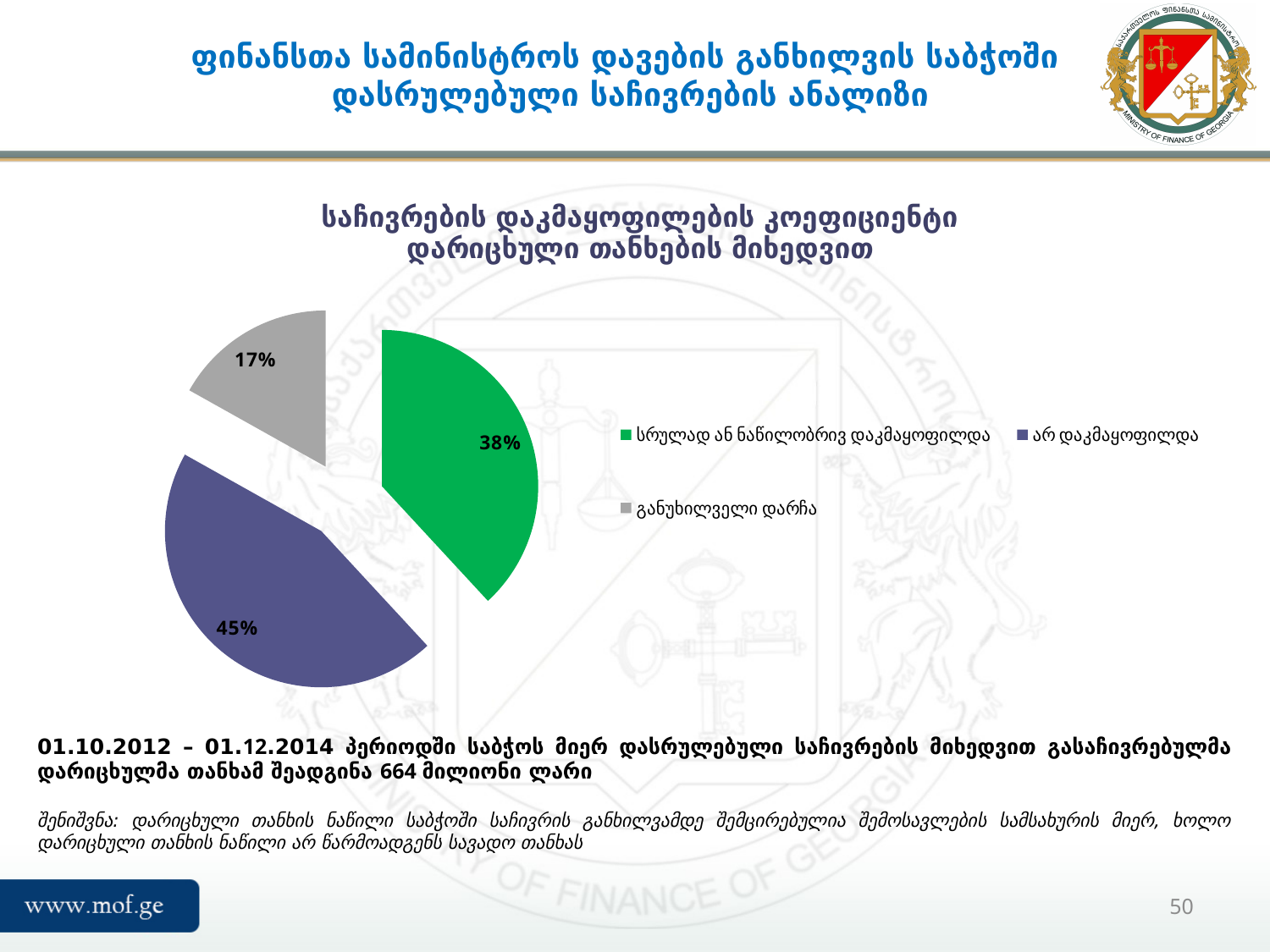
Which slice of the pie chart is the largest? არ დაკმაყოფილდა (45%) Which is larger: the "სრულად ან ნაწილობრივ დაკმაყოფილდა" slice or the "განუხილველი დარჩა" slice? სრულად ან ნაწილობრივ დაკმაყოფილდა How many entries does the legend of the pie chart list? 3 What share of the pie is labelled "სრულად ან ნაწილობრივ დაკმაყოფილდა" (the green slice)? 38% What is the difference in percentage points between the "არ დაკმაყოფილდა" slice and the "სრულად ან ნაწილობრივ დაკმაყოფილდა" slice? 7 percentage points What is the title of the pie chart? საჩივრების დაკმაყოფილების კოეფიციენტი დარიცხული თანხების მიხედვით What colour is the slice representing "არ დაკმაყოფილდა"? purple What kind of chart is shown on the slide? pie chart What share of the pie is labelled "არ დაკმაყოფილდა" (the purple slice)? 45% Which slice of the pie chart is the smallest? განუხილველი დარჩა (17%) What share of the pie is labelled "განუხილველი დარჩა" (the grey slice)? 17% How many slices does the pie chart have? 3